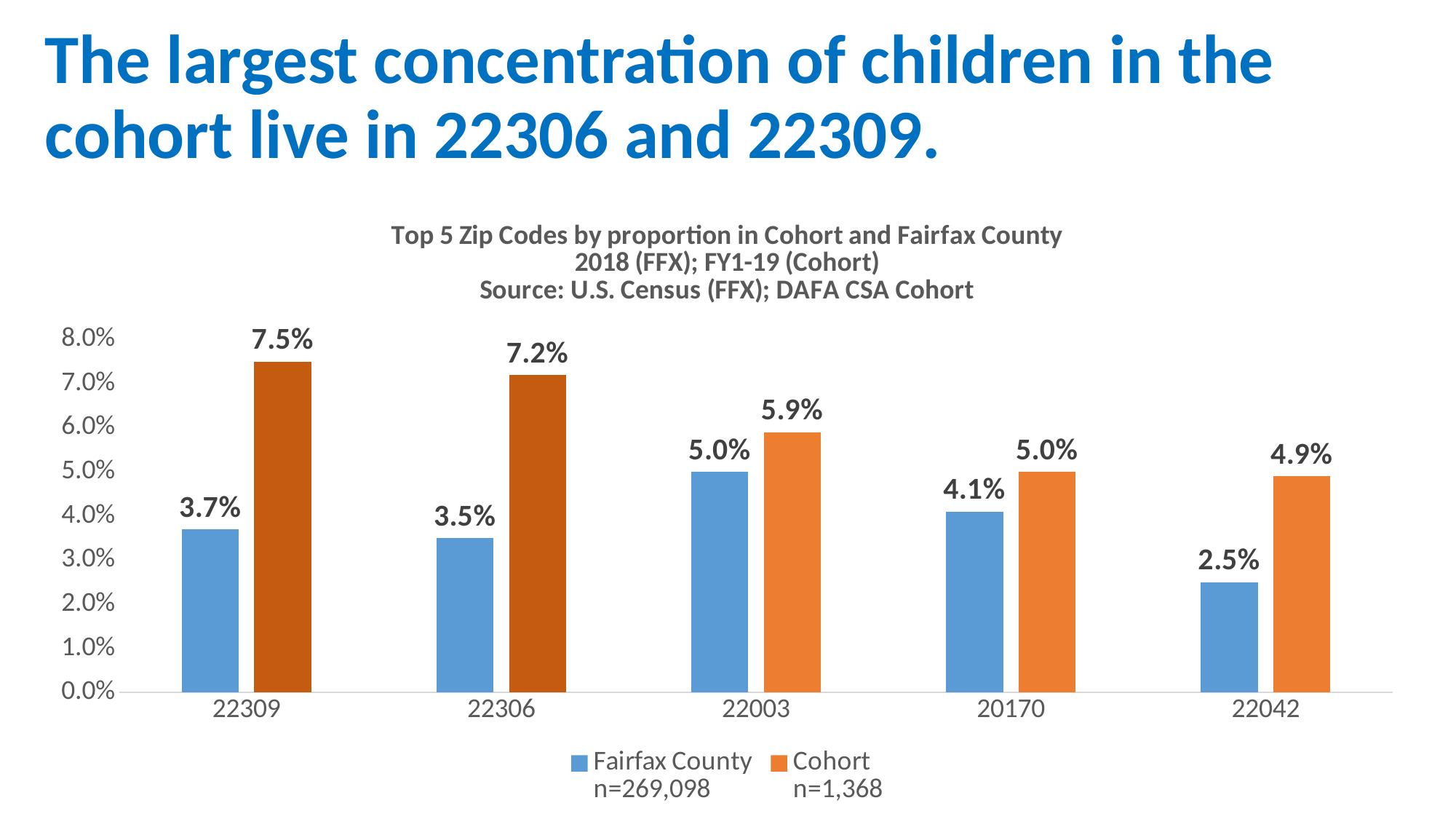
What is the difference between the Cohort and Fairfax County values for zip code 22306? 3.7% What is the Cohort value for zip code 22003? 5.9% What is the Fairfax County value for zip code 22042? 2.5% What is the sample size (n) shown in the legend for the Cohort series? n=1,368 What is the Cohort value for zip code 22309? 7.5% Which zip code has the highest Cohort value? 22309 How many series does the legend list? 2 Which zip code has the lowest Fairfax County value? 22042 Is the Cohort value for zip code 22042 greater or less than 4.0%? greater What kind of chart is shown on the slide? Bar chart Which is larger for zip code 20170: the Fairfax County value or the Cohort value? Cohort How many zip codes are shown on the x axis? 5